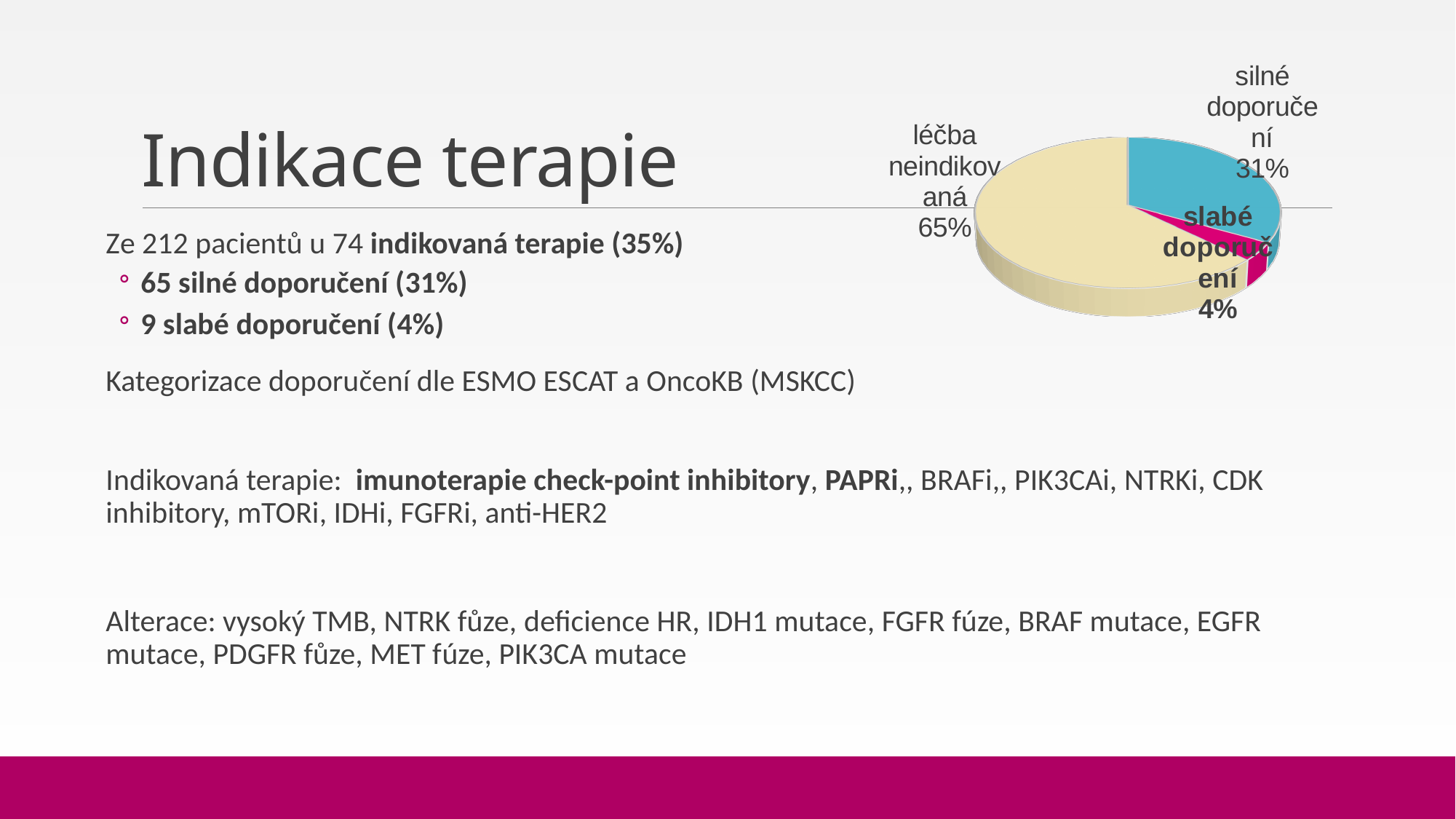
What kind of chart is shown on the slide? pie chart What share of the pie does "silné doporučení" represent? 31% Which is larger in the pie chart, "silné doporučení" or "slabé doporučení"? silné doporučení How many slices does the pie chart have? 3 Which slice of the pie chart is the largest? léčba neindikovaná What is the combined share of "silné doporučení" and "slabé doporučení"? 35% What is the difference in percentage points between "léčba neindikovaná" and "silné doporučení"? 34 What is the difference in percentage points between "silné doporučení" and "slabé doporučení"? 27 What share of the pie does "slabé doporučení" represent? 4% What share of the pie does "léčba neindikovaná" represent? 65% Which slice of the pie chart is the smallest? slabé doporučení What colour is the "léčba neindikovaná" slice in the pie chart? beige